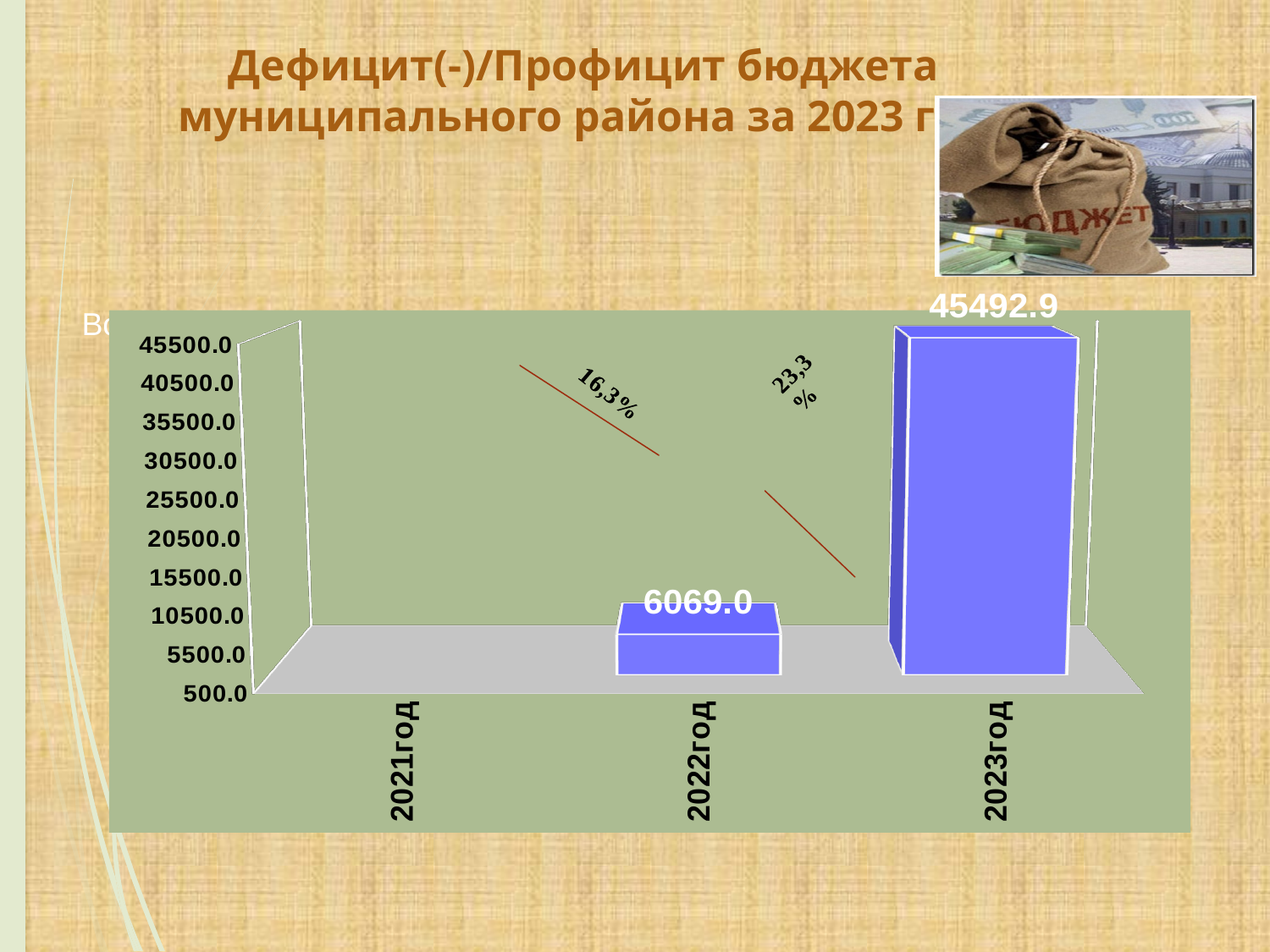
Which is larger, the value for 2022год or the value for 2023год? 2023год What is the value for 2023год? 45492.9 What is the value for 2022год? 6069.0 Which year has the highest value on the chart? 2023год What kind of chart is shown on the slide? bar chart What percentage is written in the annotation between the 2021год and 2022год bars? 16,3% Is the value for 2022год greater or less than 10500.0? less Is the value for 2023год greater or less than 40500.0? greater How many year categories are shown on the x axis? 3 What is the difference between the values for 2023год and 2022год? 39423.9 What percentage is written in the annotation between the 2022год and 2023год bars? 23,3% Does the value rise or fall from 2022год to 2023год? rise